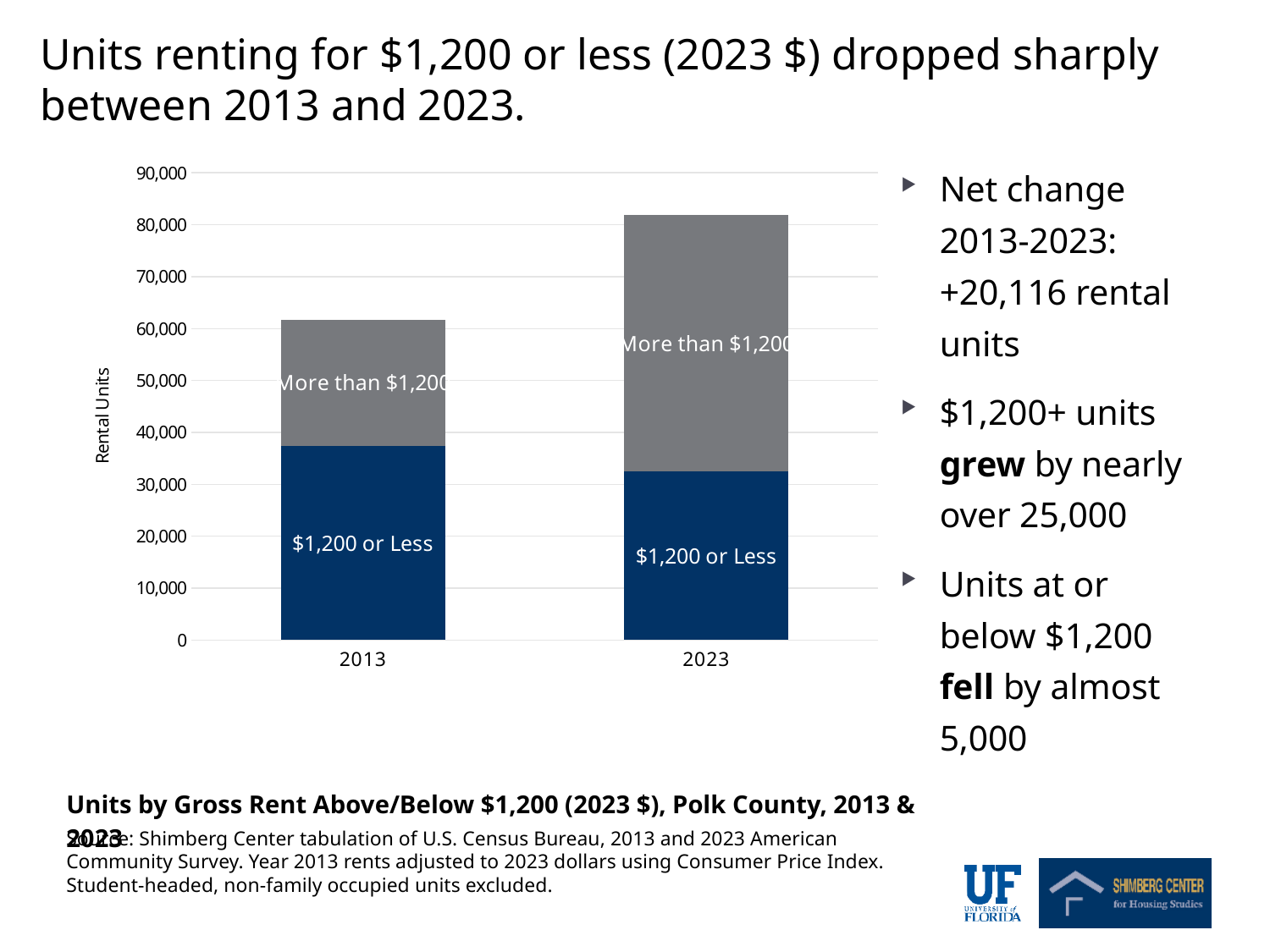
Is the total height of the 2013 bar greater or less than 70,000 rental units? less What is the label on the vertical axis of the chart? Rental Units Is the '$1,200 or Less' segment for 2023 greater or less than 30,000 rental units? greater How many years (categories) are shown on the x axis of the chart? 2 Is the total height of the 2023 bar greater or less than 70,000 rental units? greater What kind of chart is shown on the slide? Stacked bar chart Does the '$1,200 or Less' segment rise or fall from 2013 to 2023? fall Which year has the larger 'More than $1,200' segment, 2013 or 2023? 2023 Which year has the larger '$1,200 or Less' segment, 2013 or 2023? 2013 How many rent segments make up each stacked bar in the chart? 2 Which year has the larger total number of rental units, 2013 or 2023? 2023